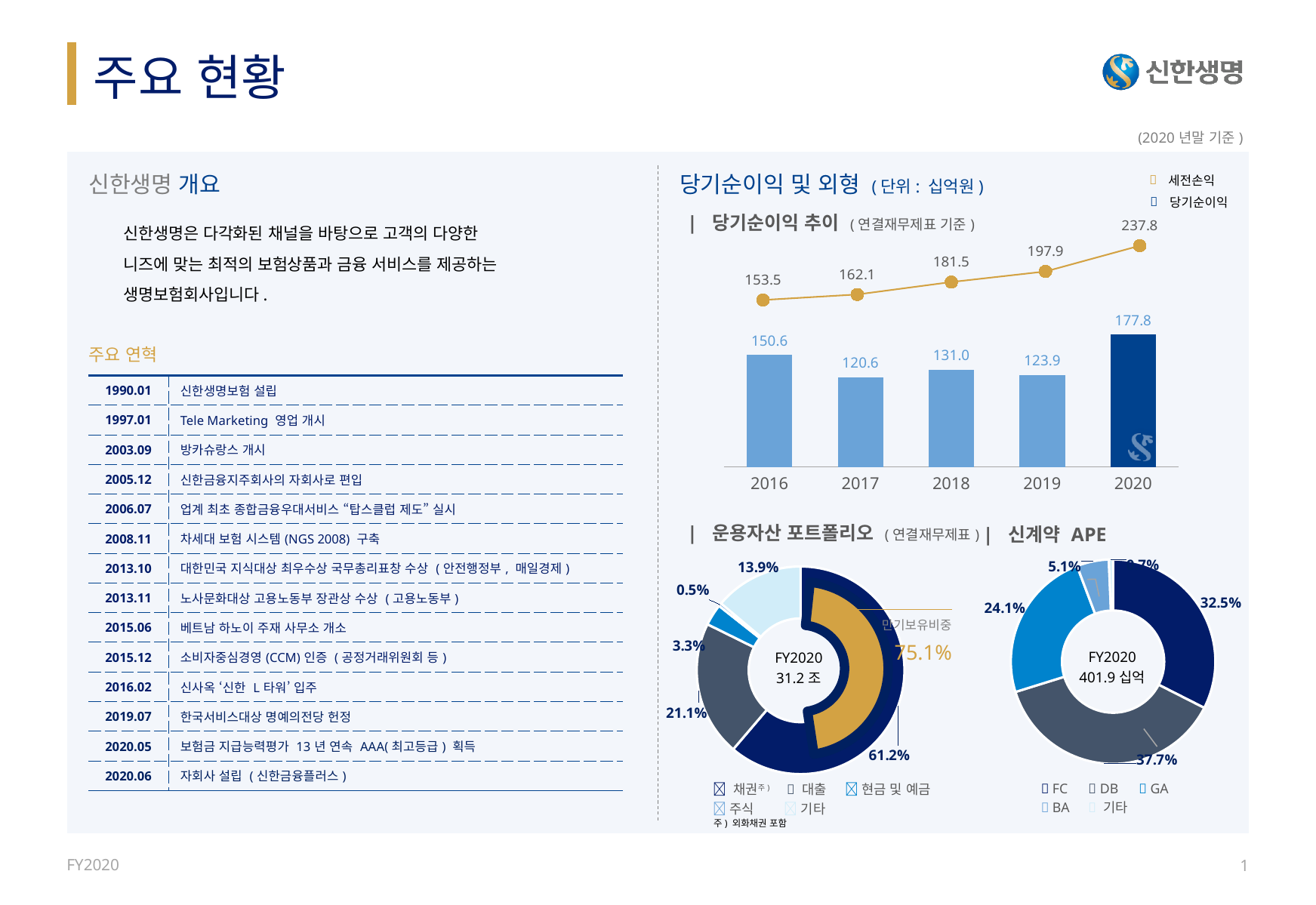
In the 운용자산 포트폴리오 donut chart, what is the share of the largest slice? 61.2% In the 당기순이익 추이 chart, what is the 당기순이익 value for 2020? 177.8 How many series does the legend of the 당기순이익 추이 chart list? 2 In the 당기순이익 추이 chart, which year has the lowest 당기순이익 bar? 2017 In the 당기순이익 추이 chart, what is the 세전손익 value for 2019? 197.9 In the 당기순이익 추이 chart, does the 세전손익 line rise or fall from 2016 to 2020? rise In the 당기순이익 추이 chart, what is the difference between the 세전손익 values for 2020 and 2019? 39.9 In the 당기순이익 추이 chart, which year has the highest 세전손익 value? 2020 In the 당기순이익 추이 chart, is the 당기순이익 for 2018 larger or smaller than for 2019? larger How many years are shown on the x axis of the 당기순이익 추이 chart? 5 What total value is shown in the centre of the 신계약 APE donut chart? 401.9 십억 In the 당기순이익 추이 chart, what is the 세전손익 value for 2016? 153.5